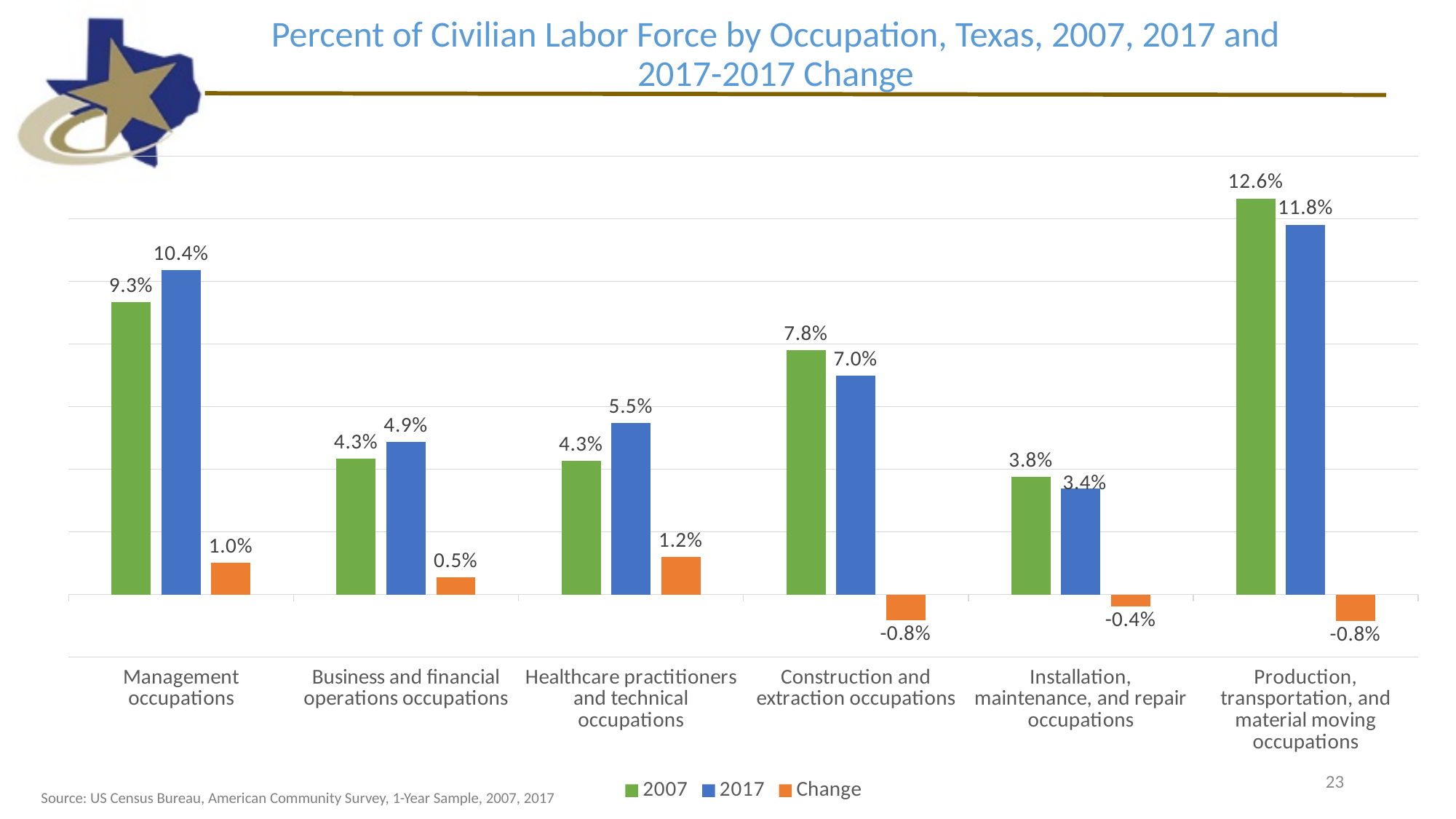
What is the Change value for Installation, maintenance, and repair occupations? -0.4% Which is larger for Construction and extraction occupations, the 2007 value or the 2017 value? 2007 How many occupation categories are shown on the chart? 6 Which occupation category has the lowest 2017 value? Installation, maintenance, and repair occupations How many series does the legend list? 3 What was the 2017 value for Management occupations? 10.4% Which colour represents the Change series in the legend? Orange What is the difference between the 2017 and 2007 values for Healthcare practitioners and technical occupations? 1.2% What kind of chart is shown on the slide? Bar chart What was the 2007 value for Construction and extraction occupations? 7.8% Which occupation category has the highest 2017 value? Production, transportation, and material moving occupations What is the Change value for Healthcare practitioners and technical occupations? 1.2%